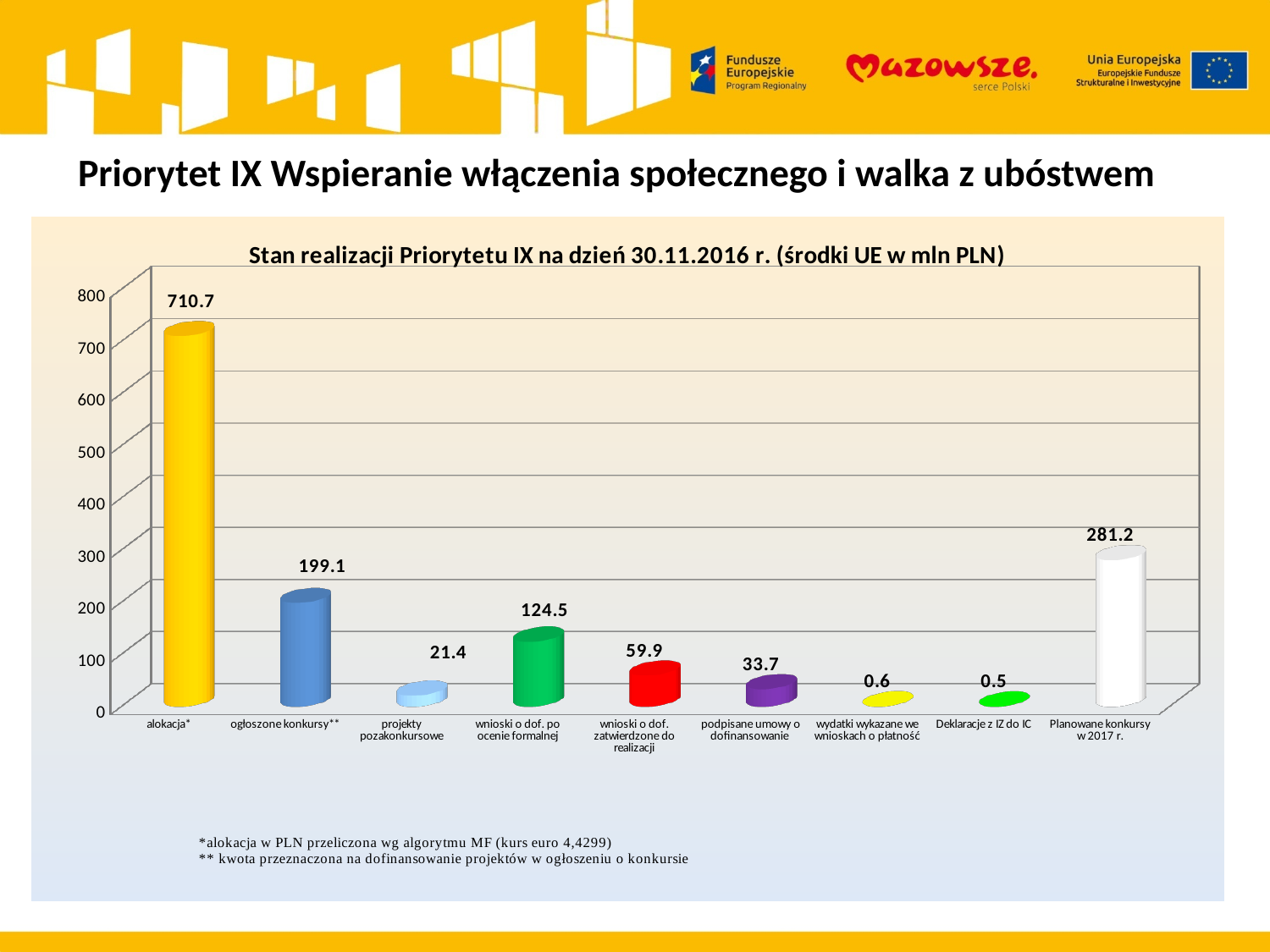
What is the value for podpisane umowy o dofinansowanie? 33.7 What is the value for Planowane konkursy w 2017 r.? 281.2 What is the difference between the values for wnioski o dof. po ocenie formalnej and wnioski o dof. zatwierdzone do realizacji? 64.6 What kind of chart is shown on the slide? bar chart What is the value for ogłoszone konkursy**? 199.1 Is the value for alokacja* greater or less than 700? greater What is the title of the chart? Stan realizacji Priorytetu IX na dzień 30.11.2016 r. (środki UE w mln PLN) How many categories are shown on the chart? 9 Which category has the lowest value? Deklaracje z IZ do IC Which is larger: the value for ogłoszone konkursy** or the value for Planowane konkursy w 2017 r.? Planowane konkursy w 2017 r. What is the value for alokacja*? 710.7 Which category has the highest value? alokacja*